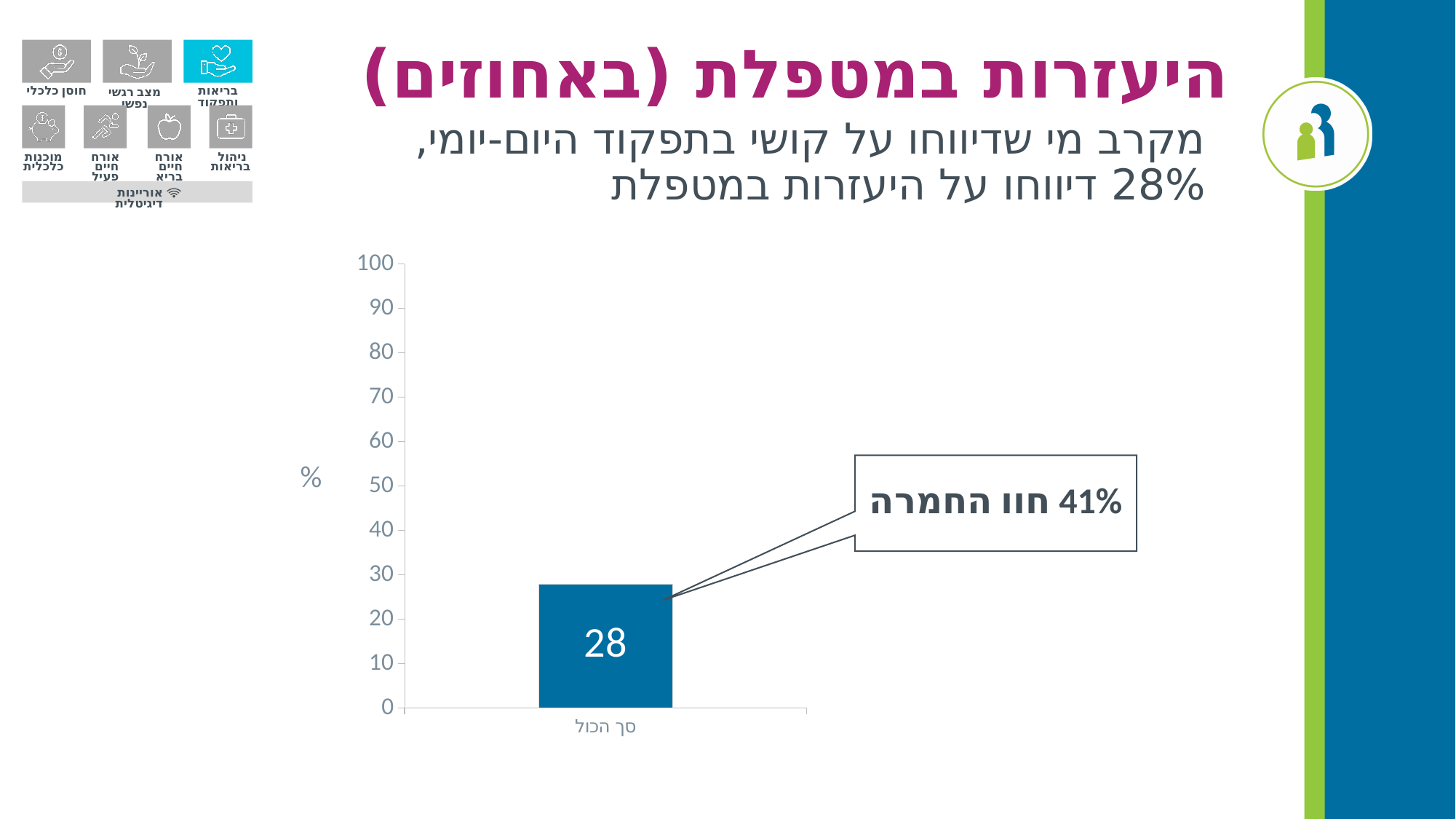
What is the highest value shown on the vertical axis? 100 What unit symbol is shown as the vertical axis label? % What is the label of the category on the horizontal axis? סך הכול What is the difference between the callout value (41%) and the bar value (28)? 13 What percentage is given in the callout box next to the bar? 41% Is the value for "סך הכול" greater or less than 20? greater What kind of chart is shown on the slide? bar chart Is the value for "סך הכול" greater or less than 30? less What is the value of the bar for "סך הכול"? 28 How many bars are plotted in the chart? 1